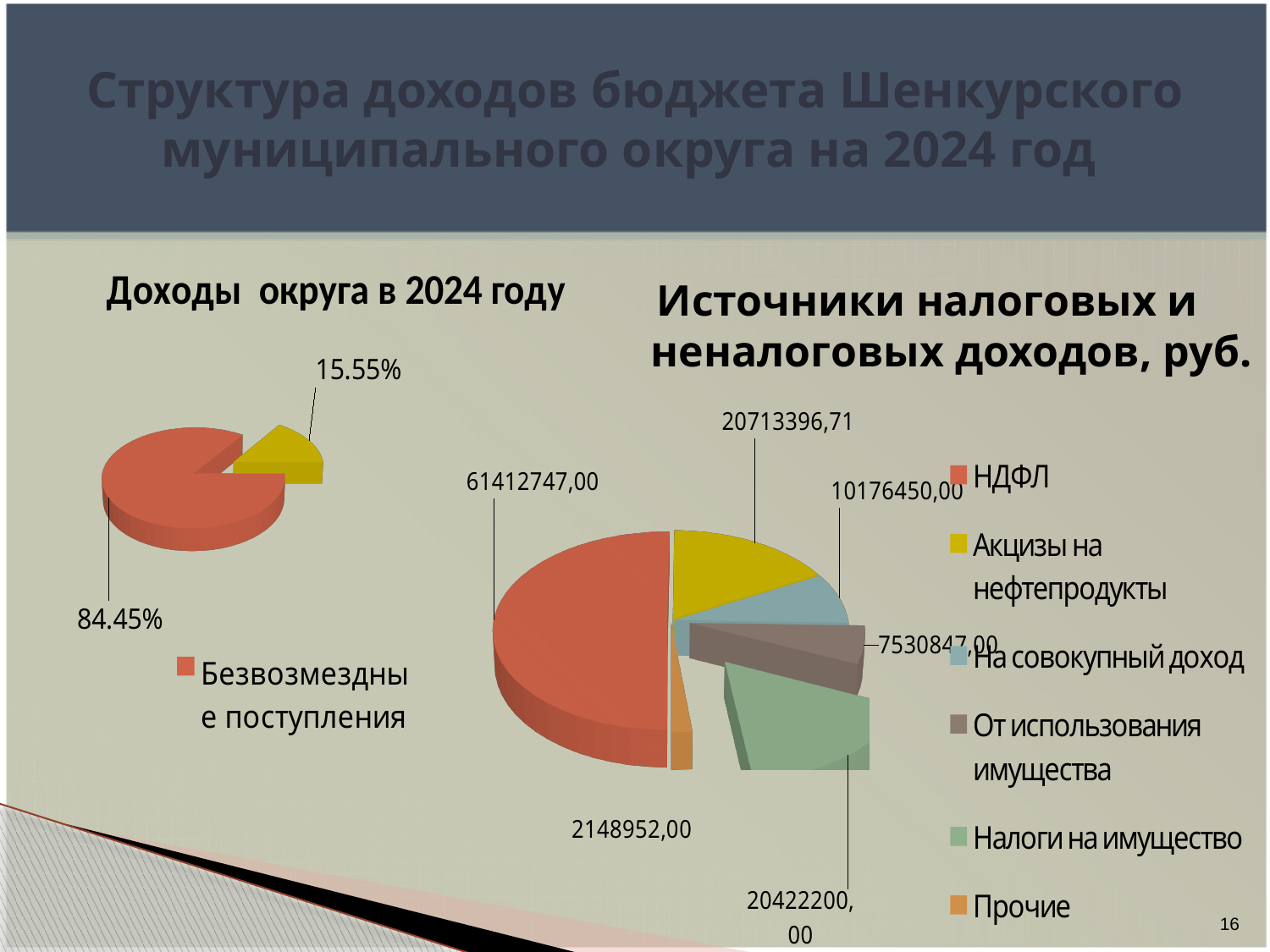
In the chart 'Источники налоговых и неналоговых доходов, руб.', what is the value for Акцизы на нефтепродукты? 20713396,71 In the chart 'Доходы округа в 2024 году', what share does Безвозмездные поступления have? 84.45% What kind of chart is 'Источники налоговых и неналоговых доходов, руб.'? Pie chart How many slices does the chart 'Доходы округа в 2024 году' have? 2 In the chart 'Источники налоговых и неналоговых доходов, руб.', which source has the largest value? НДФЛ In the chart 'Источники налоговых и неналоговых доходов, руб.', which is larger: На совокупный доход or От использования имущества? На совокупный доход In the chart 'Источники налоговых и неналоговых доходов, руб.', what is the difference between НДФЛ and Акцизы на нефтепродукты? 40699350,29 In the chart 'Источники налоговых и неналоговых доходов, руб.', what is the value for Прочие? 2148952,00 In the chart 'Источники налоговых и неналоговых доходов, руб.', what is the value for НДФЛ? 61412747,00 How many entries does the legend of the chart 'Источники налоговых и неналоговых доходов, руб.' list? 6 In the chart 'Источники налоговых и неналоговых доходов, руб.', what is the value for От использования имущества? 7530847,00 In the chart 'Источники налоговых и неналоговых доходов, руб.', which source has the smallest value? Прочие